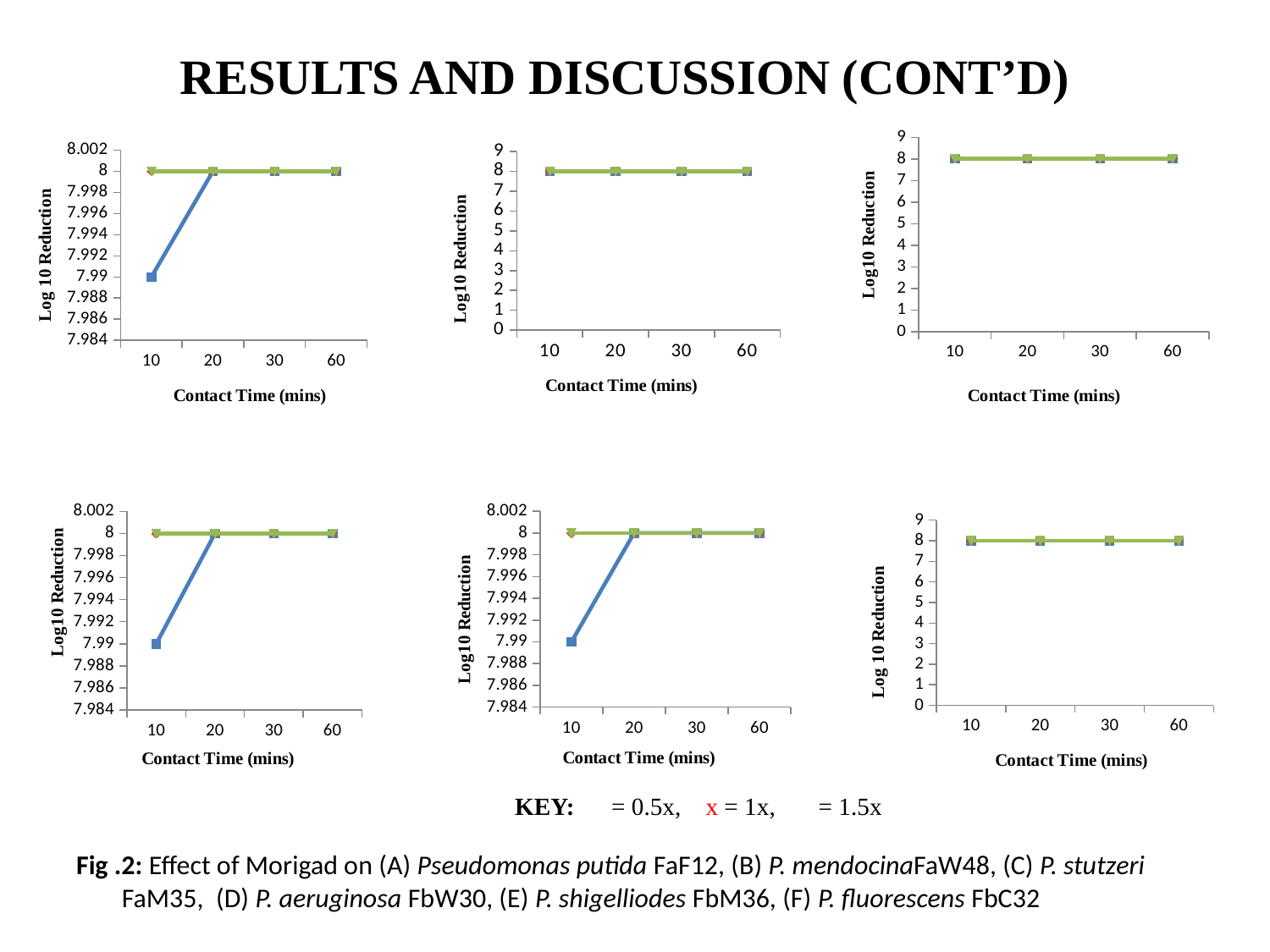
In the top-left chart, what is the value of the blue series at 10 mins? 7.99 How many contact-time points are plotted along the x axis of the top-middle chart? 4 In the bottom-right chart, is the value at 60 mins greater or less than 5? greater How many charts are shown on the slide? 6 In the top-left chart, does the blue series rise or fall between 10 and 20 mins? rise In the bottom-left chart, is the value of the blue series at 10 mins greater or less than 7.996? less In the bottom-middle chart, does the blue series rise or fall between 10 and 20 mins? rise What kind of chart is the top-left chart on the slide? line chart What is the x-axis title of the top-right chart? Contact Time (mins) How many concentrations does the key at the bottom of the slide list? 3 In the top-middle chart, is the value at 10 mins greater or less than 4? greater What is the y-axis title of the bottom-middle chart? Log10 Reduction